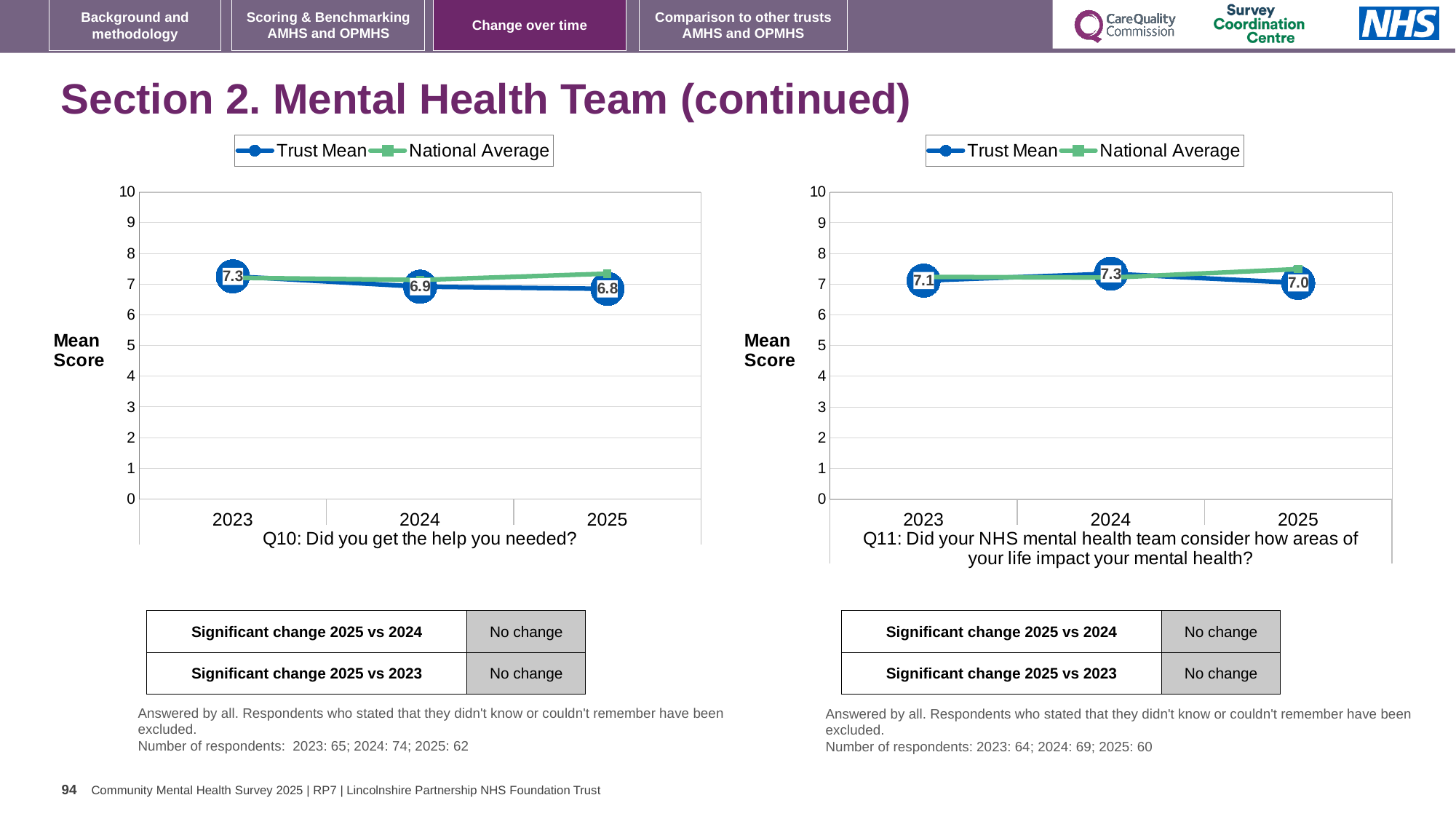
In the Q10 chart, what is the Trust Mean for 2023? 7.3 In the Q10 chart, what is the difference between the Trust Mean for 2023 and 2025? 0.5 What kind of chart is the Q11 chart? line chart In the Q10 chart, which year has the lowest Trust Mean? 2025 In the Q11 chart, is the Trust Mean for 2023 or 2024 larger? 2024 In the Q10 chart, what is the Trust Mean for 2025? 6.8 In the Q11 chart, which year has the highest Trust Mean? 2024 In the Q10 chart, does the Trust Mean rise or fall from 2023 to 2025? fall In the Q11 chart, what is the Trust Mean for 2025? 7.0 How many series does the legend of the Q10 chart list? 2 How many years are plotted on the x axis of the Q11 chart? 3 In the Q11 chart, what is the Trust Mean for 2024? 7.3